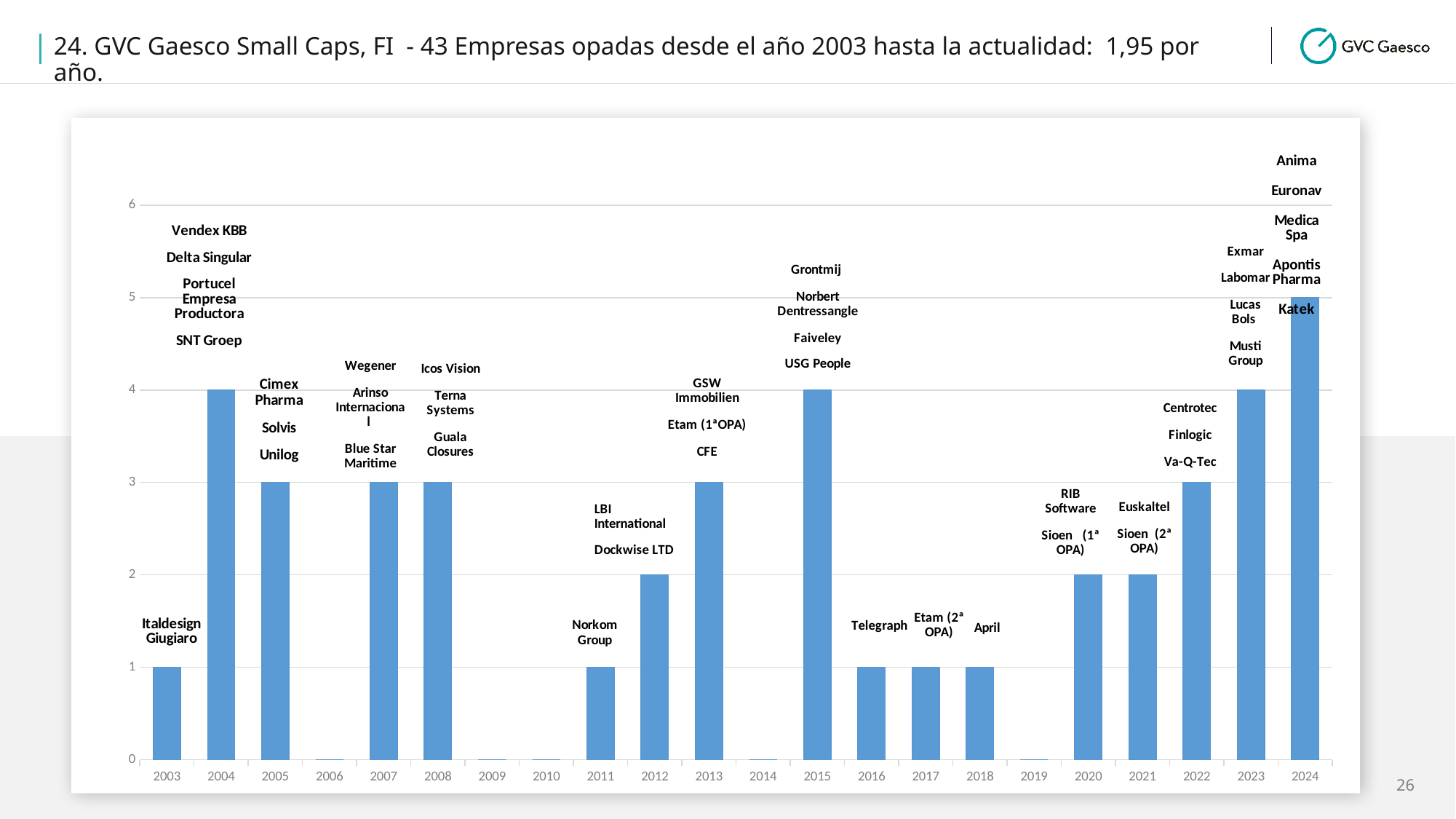
What type of chart is shown on the slide? bar chart How many years (categories) are shown on the x axis of the chart? 22 What is the difference between the values for 2024 and 2022? 2 Which year has the highest bar in the chart? 2024 What is the value of the bar for 2012? 2 What is the value of the bar for 2024? 5 What is the value of the bar for 2015? 4 Which is larger, the value for 2004 or the value for 2005? 2004 Which company names are listed above the bar for 2020? RIB Software, Sioen (1ª OPA) Which company name is shown above the bar for 2003? Italdesign Giugiaro What is the value of the bar for 2003? 1 Is the value for 2023 greater or less than 3? greater